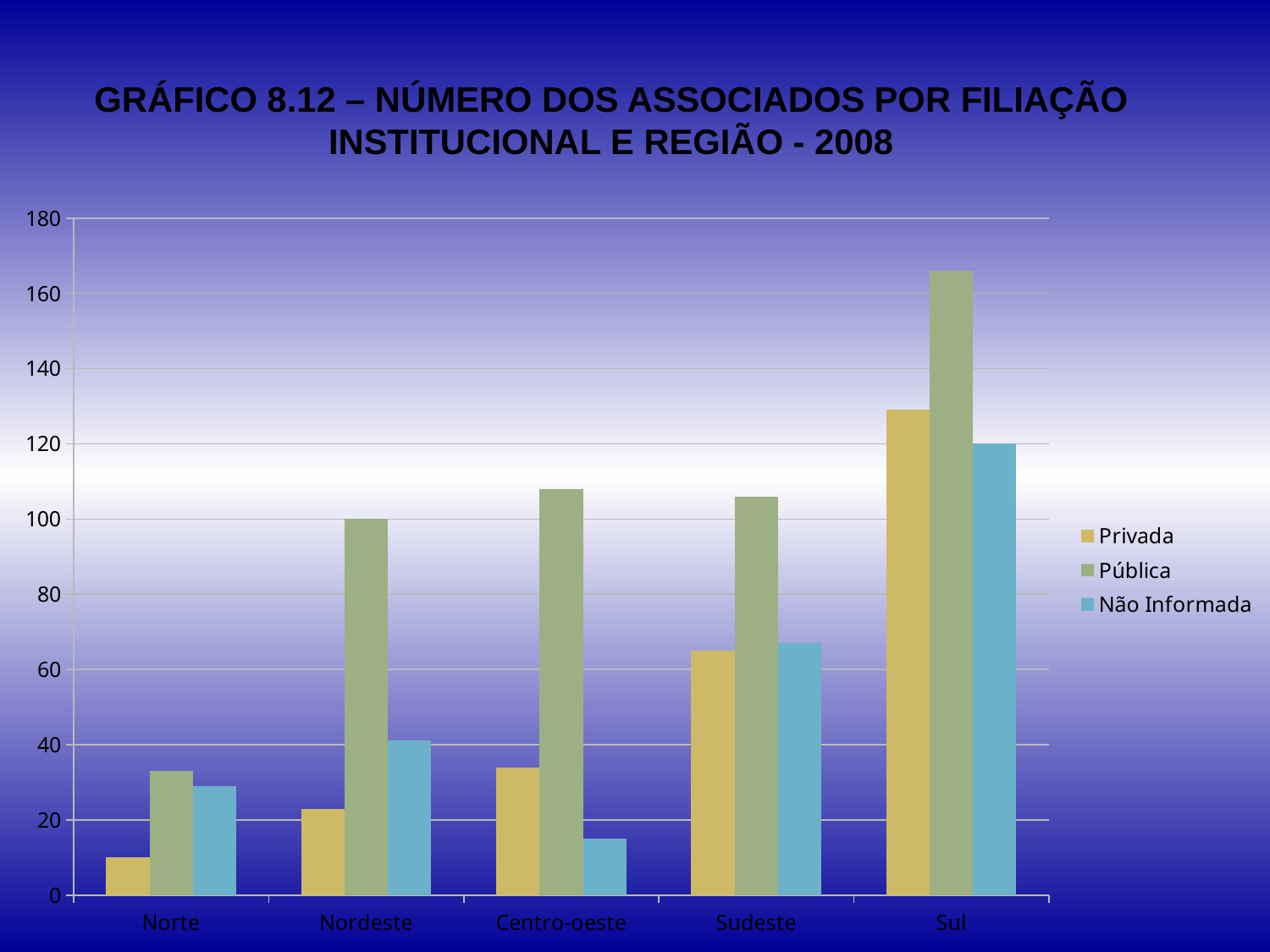
Which is larger for Sudeste, the Privada value or the Pública value? Pública Is the Pública value for Centro-oeste greater or less than 100? greater Do the Privada values rise or fall from Norte to Sul along the x axis? rise What is the Não Informada value for Sul? 120 Is the Não Informada value for Centro-oeste greater or less than 20? less What is the Pública value for Nordeste? 100 How many regions are shown on the x axis? 5 How many series does the legend list? 3 Which region has the highest Pública value? Sul Which series is shown in the legend with a blue colour? Não Informada Which region has the lowest Privada value? Norte What kind of chart is shown on the slide? bar chart